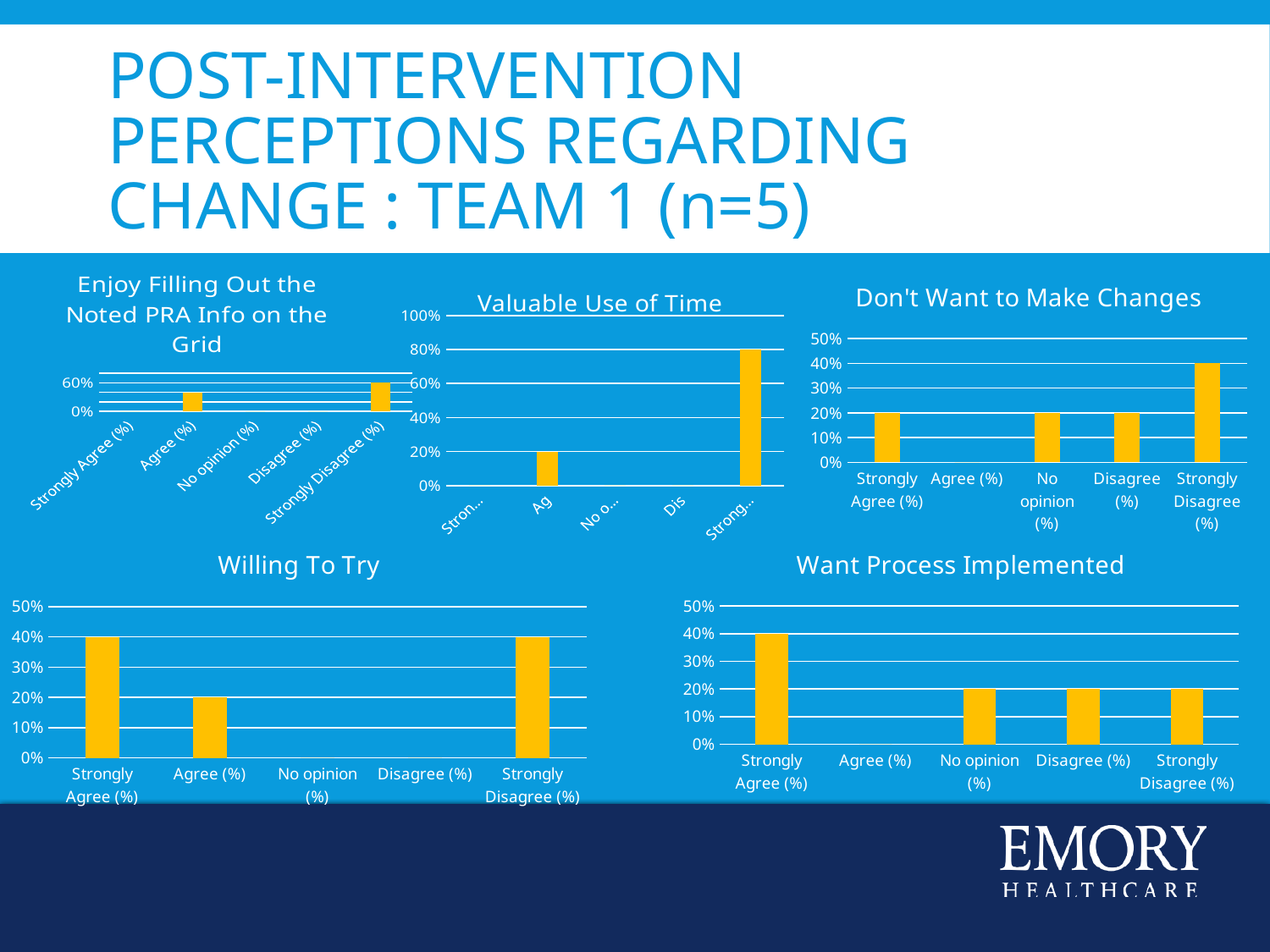
In the 'Don't Want to Make Changes' chart, what is the value for Strongly Disagree (%)? 40% How many charts are shown on the slide? 5 In the 'Willing To Try' chart, what is the value for Agree (%)? 20% In the 'Don't Want to Make Changes' chart, what is the value for Disagree (%)? 20% In the 'Want Process Implemented' chart, is the value for Strongly Disagree (%) greater or less than 30%? less In the 'Want Process Implemented' chart, what is the value for Strongly Agree (%)? 40% In the 'Willing To Try' chart, what is the difference between the Strongly Agree (%) and Agree (%) values? 20% In the 'Don't Want to Make Changes' chart, which category has the highest value? Strongly Disagree (%) What kind of chart is 'Willing To Try'? bar chart In the 'Willing To Try' chart, how many categories are shown on the x axis? 5 In the 'Valuable Use of Time' chart, what is the highest value plotted? 80% In the 'Want Process Implemented' chart, which is larger, the value for Strongly Agree (%) or the value for No opinion (%)? Strongly Agree (%)